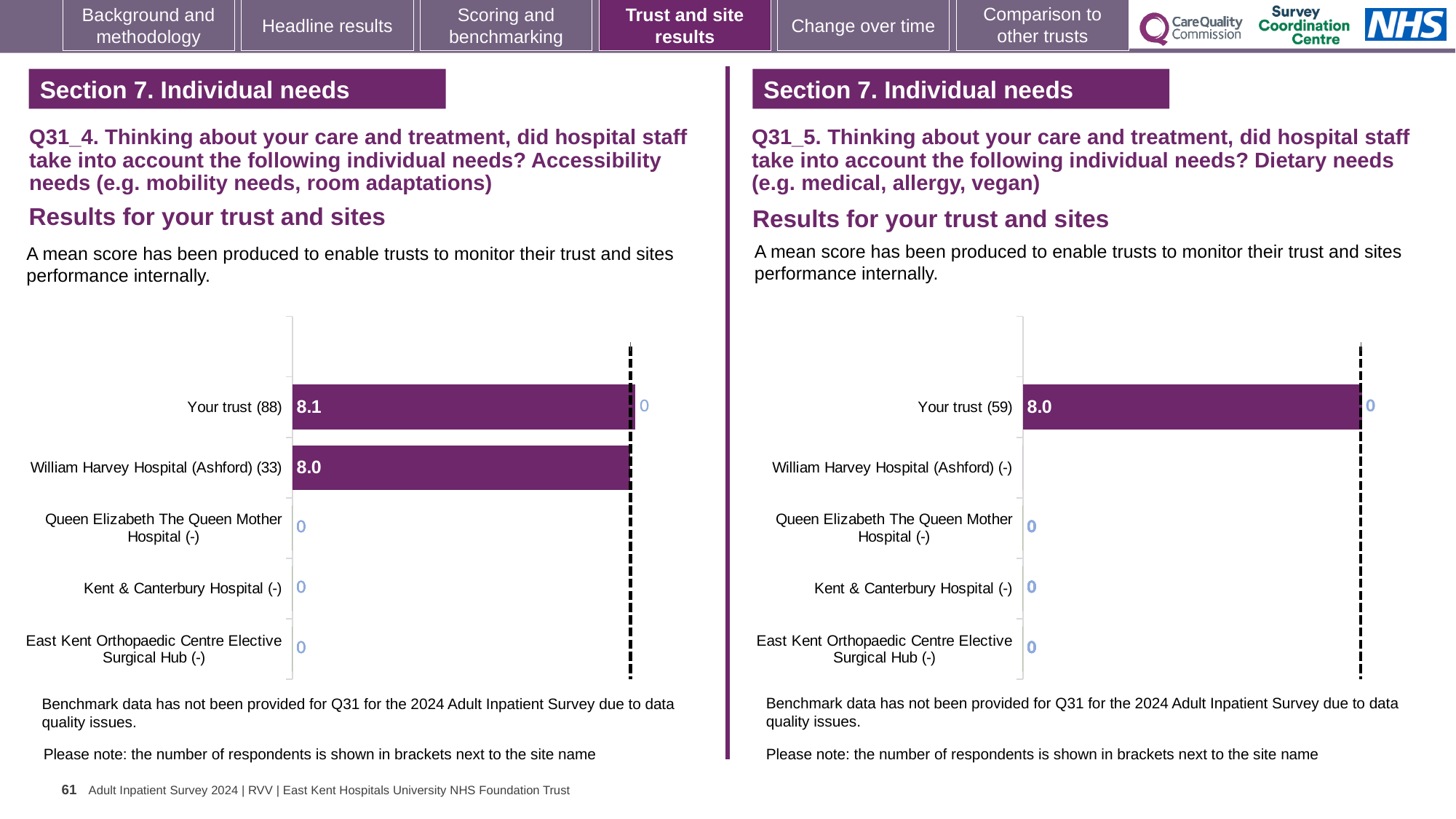
In the right chart (Q31_5, dietary needs), what is the mean score for Your trust? 8.0 In the left chart (Q31_4, accessibility needs), what value is shown for Kent & Canterbury Hospital? 0 In the left chart (Q31_4, accessibility needs), what is the mean score for Your trust? 8.1 In the left chart (Q31_4, accessibility needs), which category has the highest mean score? Your trust (88) In the left chart (Q31_4, accessibility needs), which has the higher mean score: Your trust or William Harvey Hospital (Ashford)? Your trust In the left chart (Q31_4, accessibility needs), what is the difference between the mean score for Your trust and the mean score for William Harvey Hospital (Ashford)? 0.1 In the left chart (Q31_4, accessibility needs), what is the mean score for William Harvey Hospital (Ashford)? 8.0 In the right chart (Q31_5, dietary needs), how many respondents are shown in brackets for Your trust? 59 In the left chart (Q31_4, accessibility needs), how many respondents are shown in brackets for Your trust? 88 What type of chart is used in the left chart (Q31_4, accessibility needs)? Bar chart Comparing the two charts, is the mean score for Your trust higher in the left chart (Q31_4) or the right chart (Q31_5)? Left chart (Q31_4) How many categories are listed on the vertical axis of the right chart (Q31_5, dietary needs)? 5